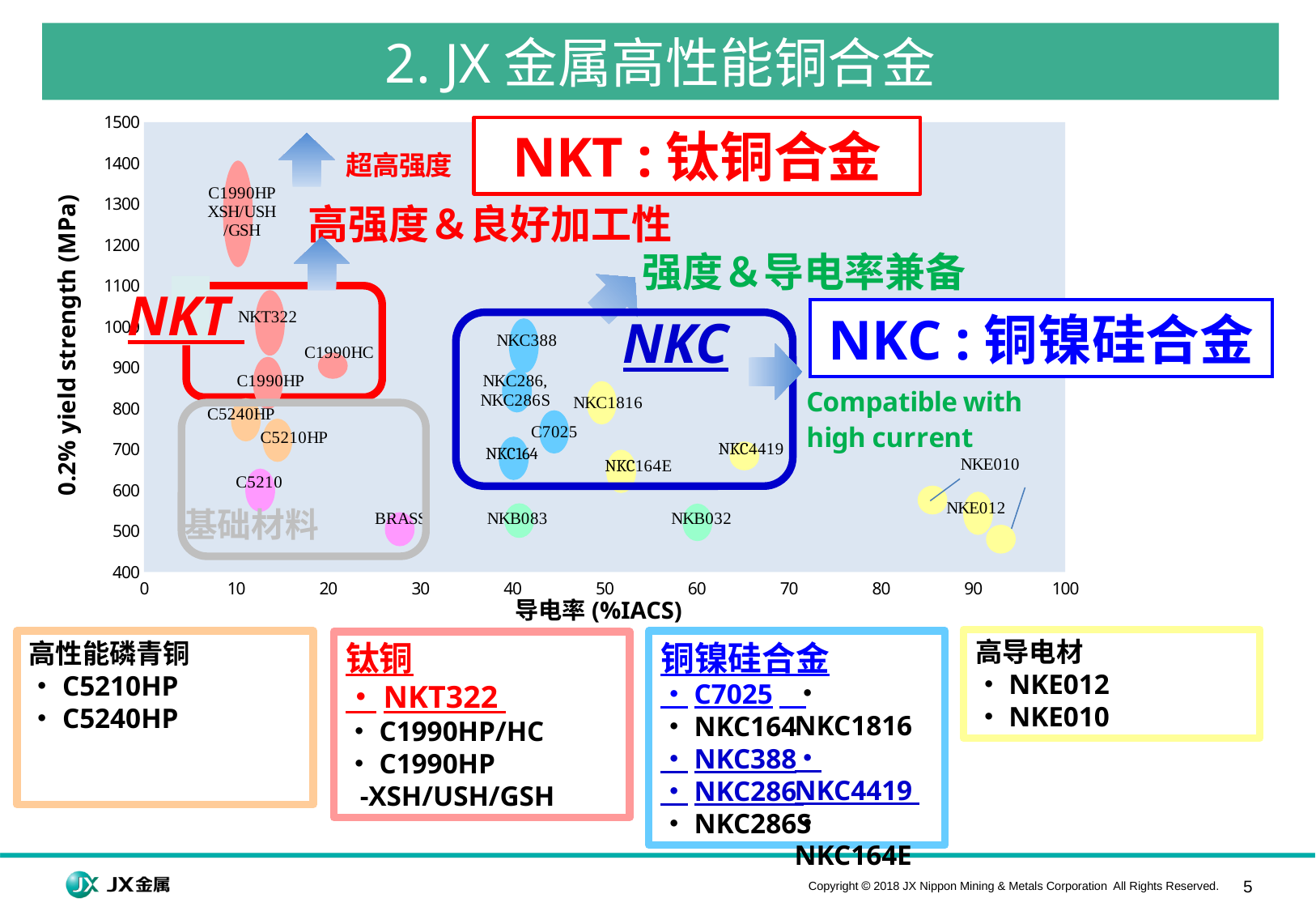
Is the 0.2% yield strength of BRASS greater or less than 600 MPa? less What is the label of the x axis of the chart? 导电率 (%IACS) Is the 0.2% yield strength of NKT322 greater or less than 900 MPa? greater What kind of chart is shown on the slide? Scatter (bubble) chart Which has the higher conductivity, NKB032 or NKB083? NKB032 Which alloy has the highest 0.2% yield strength on the chart? C1990HP XSH/USH/GSH Is the 0.2% yield strength of C1990HP XSH/USH/GSH greater or less than 1100 MPa? greater Which alloy has the highest conductivity (导电率) on the chart? NKE012 What is the label of the y axis of the chart? 0.2% yield strength (MPa) Which has the higher 0.2% yield strength, NKC388 or NKC164? NKC388